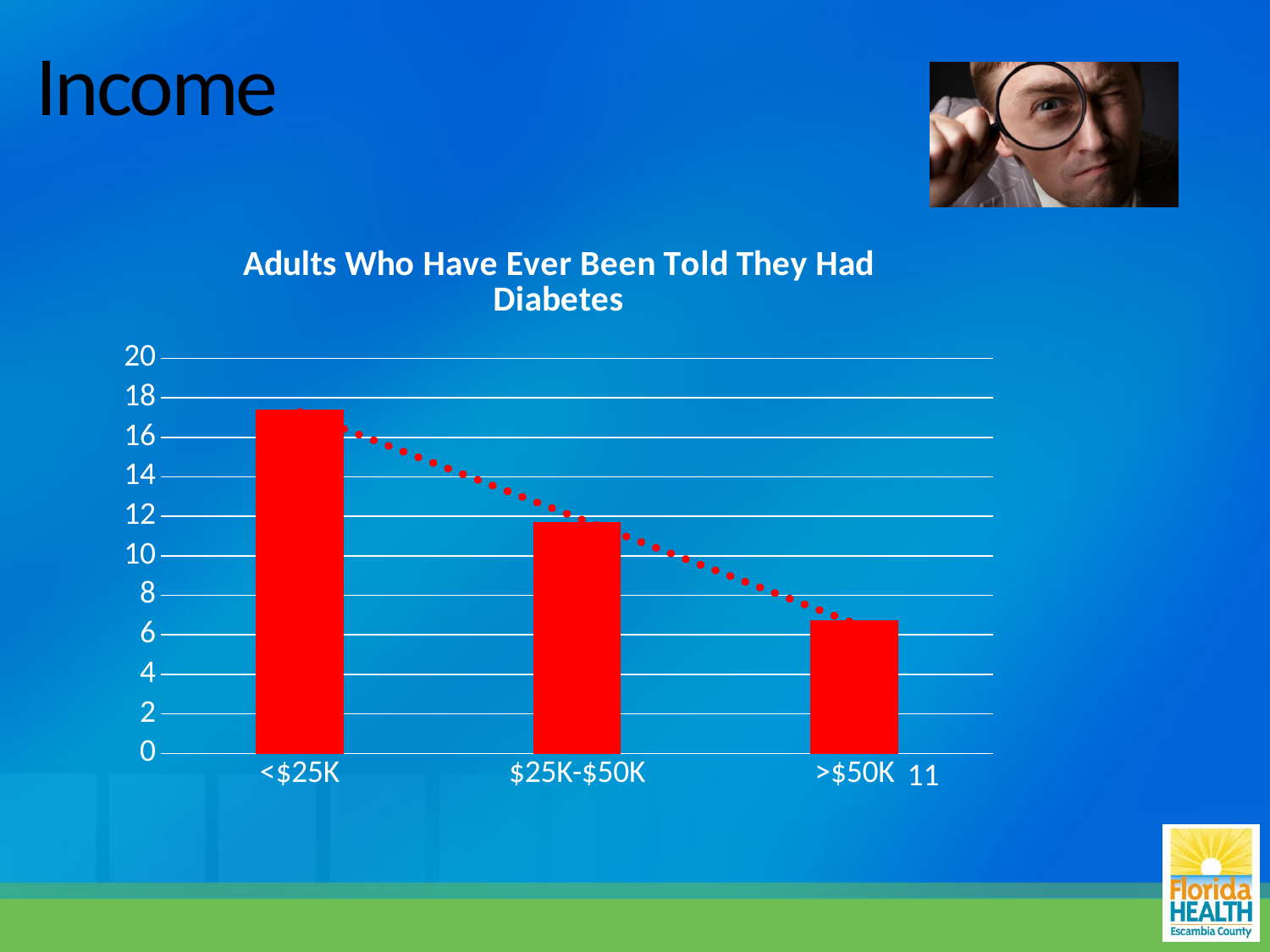
How many income categories are shown on the x axis? 3 Which is larger, the value for $25K-$50K or the value for >$50K? $25K-$50K Which income category has the lowest value? >$50K Is the value for <$25K greater or less than 18? less Is the value for $25K-$50K greater or less than 12? less Do the values rise or fall as income increases along the x axis? fall Is the value for <$25K greater or less than 16? greater Which income category has the highest value? <$25K What is the highest value shown on the y axis? 20 What is the title of the chart? Adults Who Have Ever Been Told They Had Diabetes What kind of chart is shown on the slide? bar chart